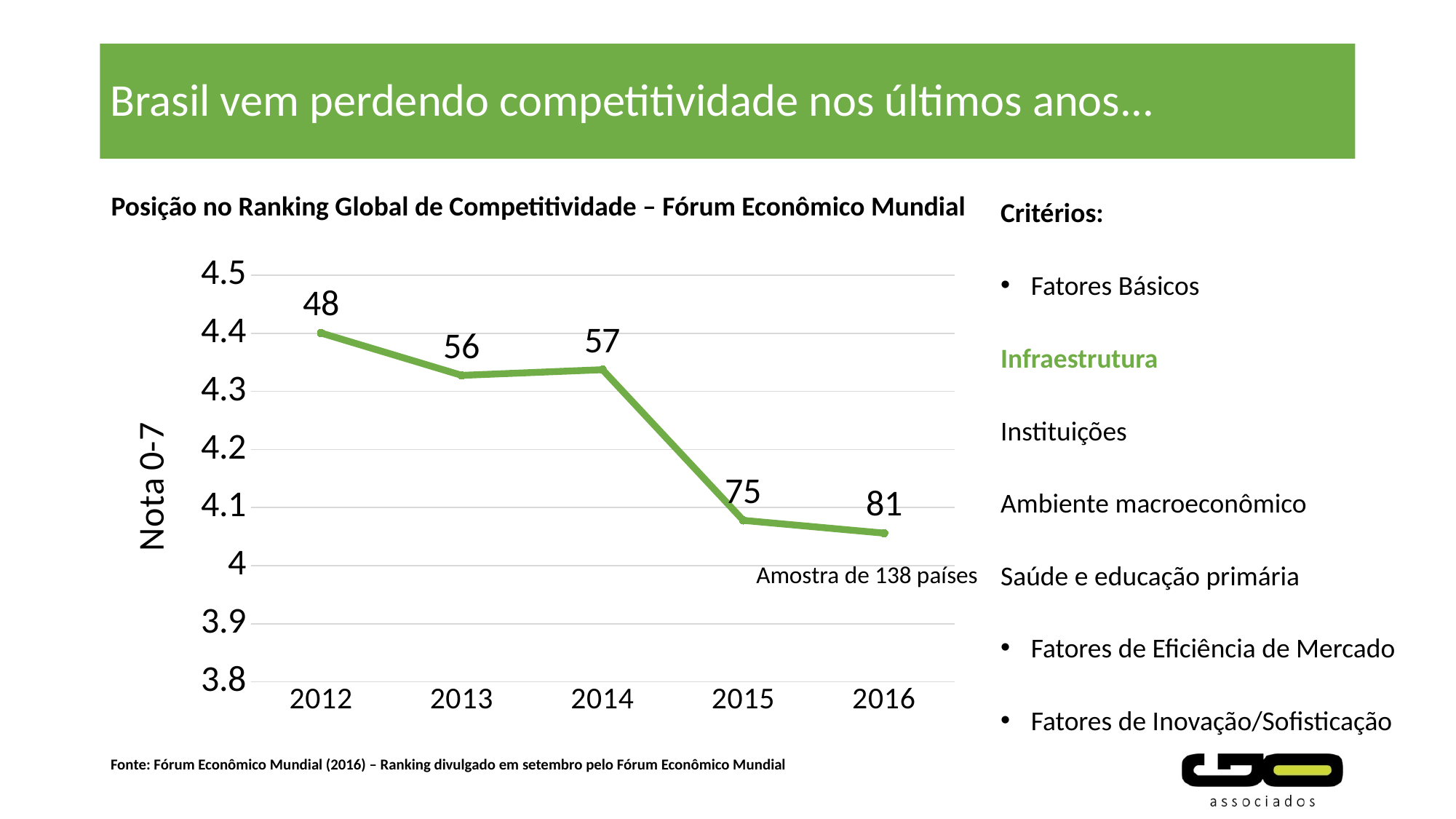
Is the plotted score for 2016 greater or less than 4.1? less How many years are plotted on the x axis? 5 In which year is the plotted score (Nota 0-7) highest? 2012 What ranking position is labelled for 2012? 48 By how many positions does the labelled ranking for 2016 differ from that for 2012? 33 What kind of chart is shown on the slide? line chart What ranking position is labelled for 2016? 81 In which year is the plotted score (Nota 0-7) lowest? 2016 What ranking position is labelled for 2015? 75 Does the plotted score rise or fall from 2012 to 2016? fall What ranking position is labelled for 2014? 57 Is the plotted score for 2014 greater or less than 4.3? greater